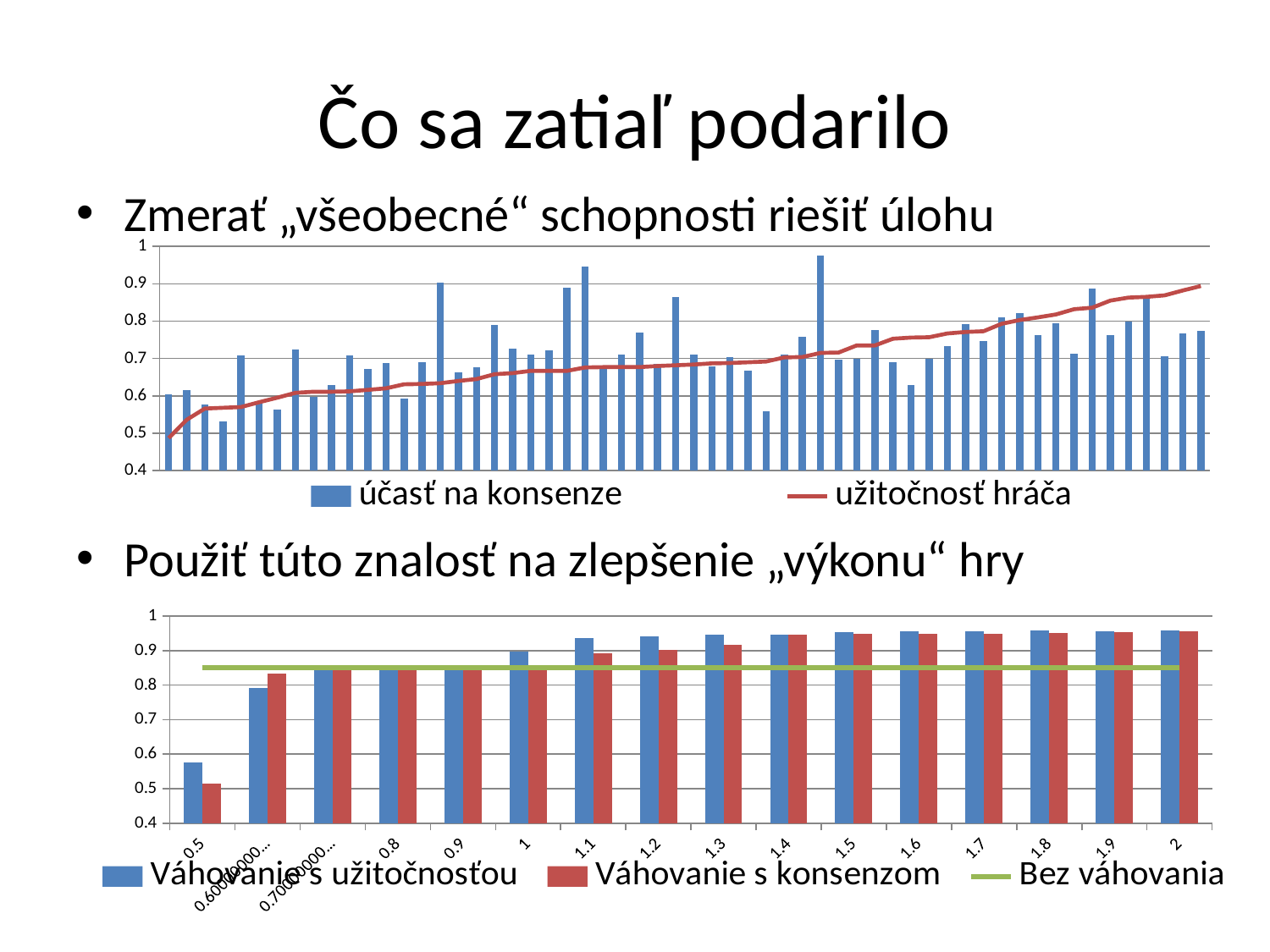
In the bottom chart, is the value of Váhovanie s užitočnosťou for category 0.5 greater or less than 0.6? less In the bottom chart, which category has the lowest value for Váhovanie s konsenzom? 0.5 In the bottom chart, do the values of Váhovanie s užitočnosťou generally rise or fall from category 0.5 to category 2? rise In the bottom chart, for category 0.5, which is larger: Váhovanie s užitočnosťou or Váhovanie s konsenzom? Váhovanie s užitočnosťou In the bottom chart, is the value of Váhovanie s užitočnosťou for category 1 greater or less than 0.8? greater In the bottom chart, is the value of Váhovanie s konsenzom for category 2 greater or less than 0.9? greater In the top chart, does the line for užitočnosť hráča rise or fall along the x axis? rise In the bottom chart, how many categories are shown on the x axis? 16 What kind of chart is the bottom chart? combination bar and line chart In the top chart, how many series does the legend list? 2 In the bottom chart, what is the name of the series drawn as a green line? Bez váhovania In the bottom chart, how many series does the legend list? 3